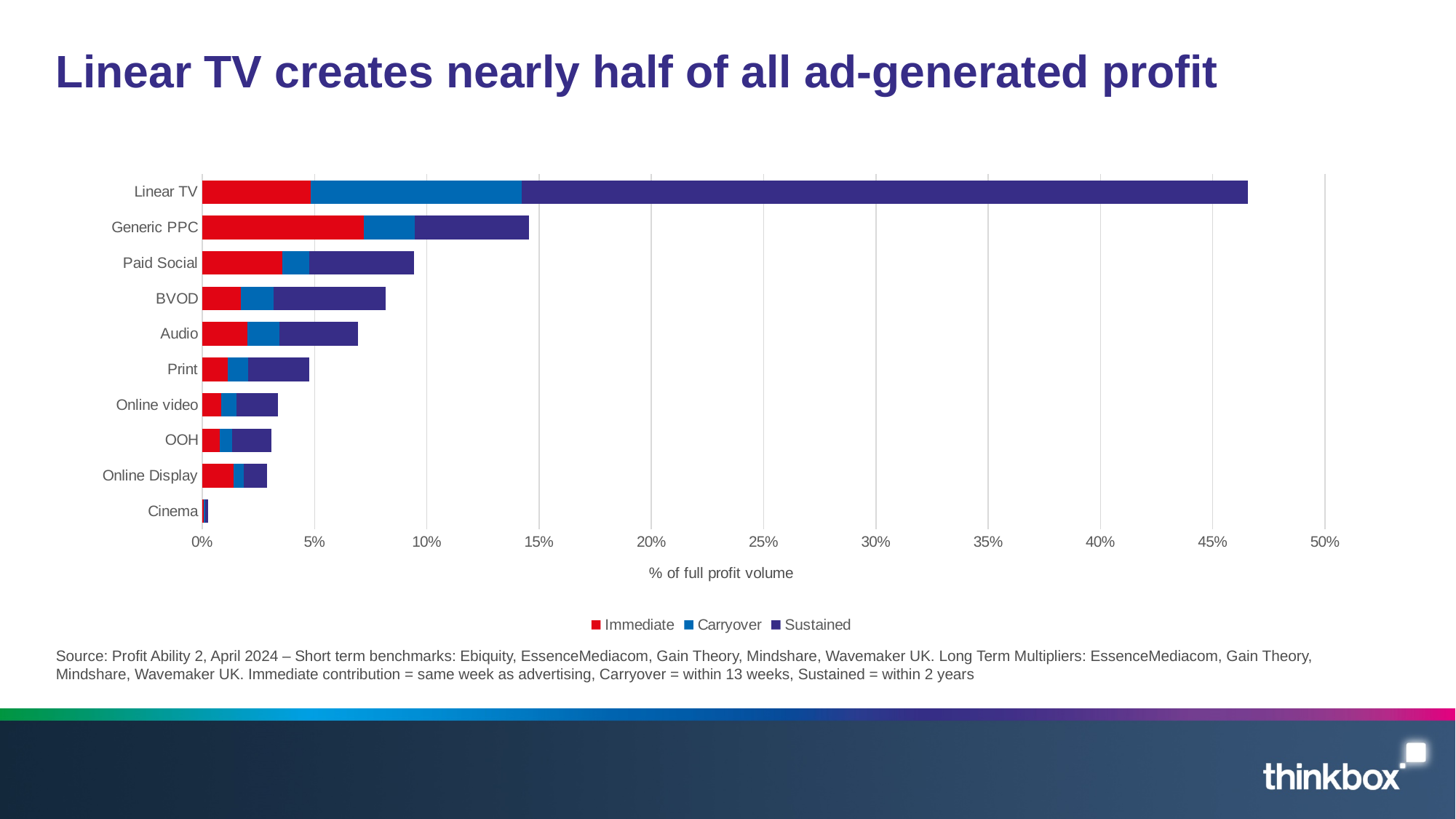
How many media channels (categories) are plotted on the chart? 10 How many series does the legend list? 3 Is the total value for Generic PPC greater or less than 10%? greater Which has a larger total bar, Audio or Print? Audio What is the label on the horizontal axis of the chart? % of full profit volume Is the total value for Linear TV greater or less than 45%? greater Is the total value for Online video greater or less than 5%? less What kind of chart is shown on the slide? Stacked bar chart Which channel has the highest total share of full profit volume? Linear TV Which has a larger total bar, Generic PPC or Paid Social? Generic PPC Which channel has the lowest total share of full profit volume? Cinema Which series is shown in red in the legend? Immediate